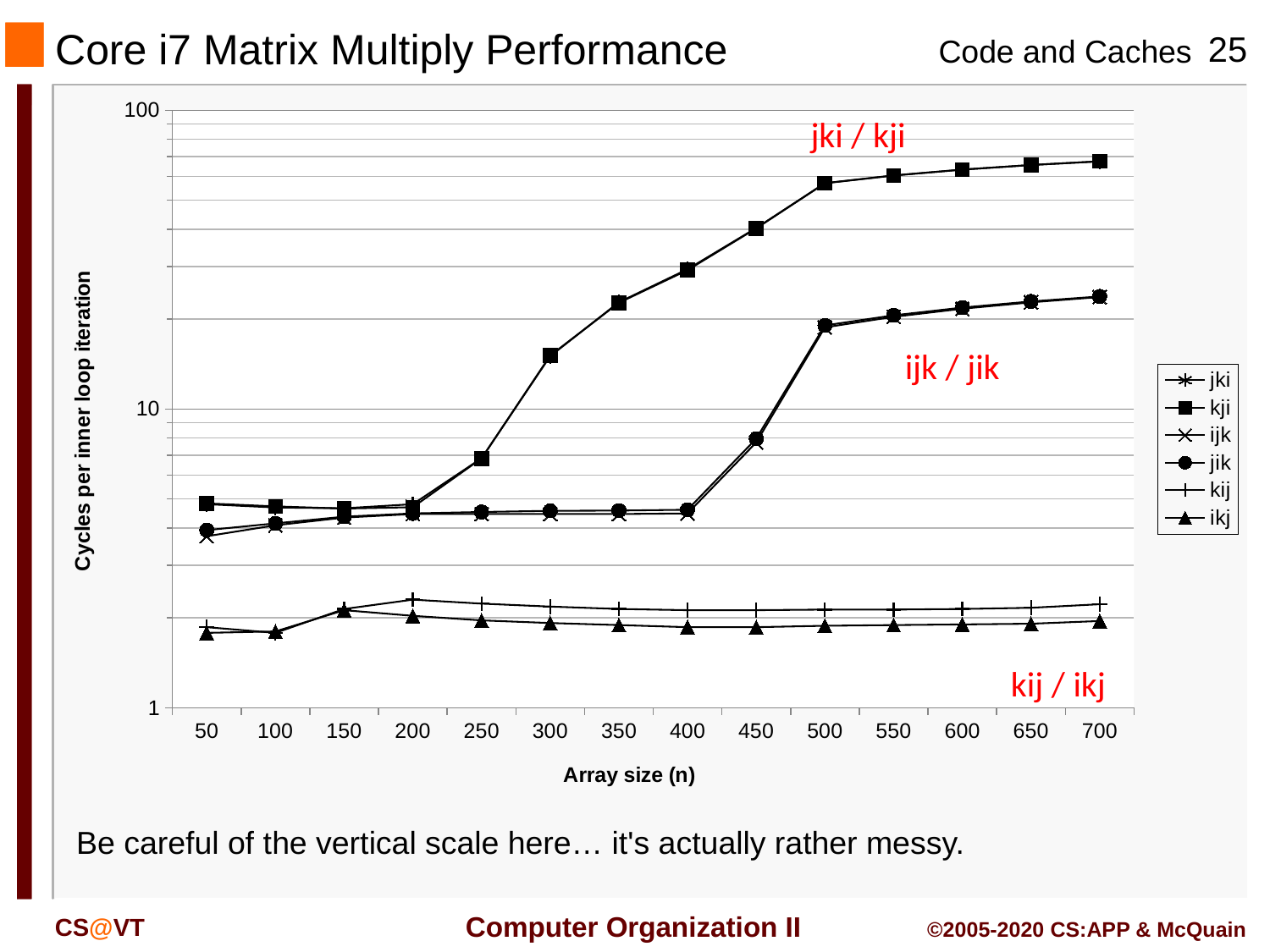
Is the value for jik at array size 500 greater or less than 10? greater How many array size values are marked along the x axis? 14 What kind of chart is shown on the slide? line chart Is the value for ijk at array size 400 greater or less than 10? less How many series does the legend list? 6 Does the value for kji rise or fall as the array size increases from 50 to 700? rise Is the value for kji at array size 700 greater or less than 10? greater At array size 300, which is larger, the value for kji or the value for ikj? kji What is the title of the vertical axis? Cycles per inner loop iteration At array size 700, which is larger, the value for kji or the value for jik? kji